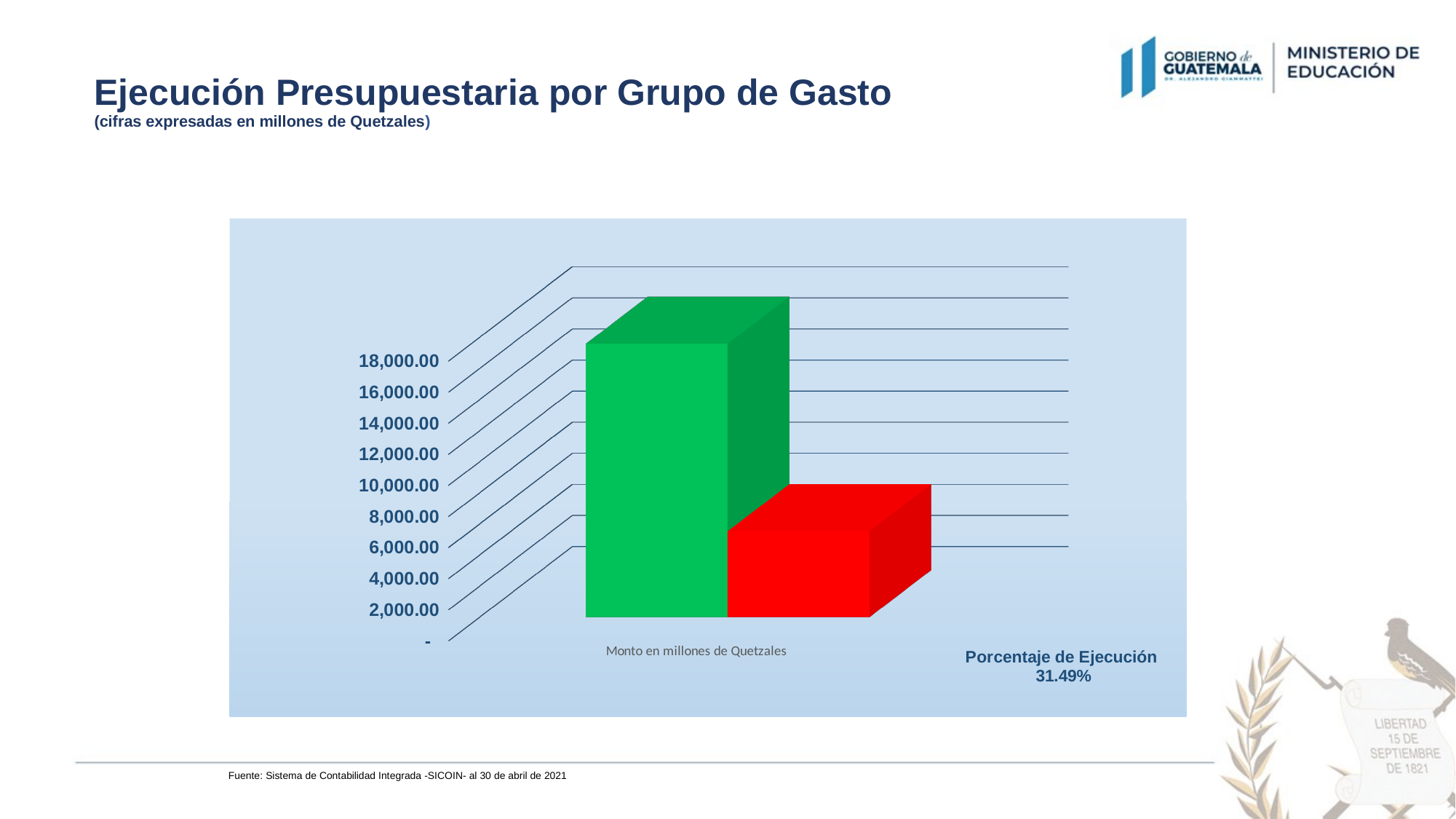
What kind of chart is shown on the slide? bar chart Is the value of the green bar greater or less than 14,000.00? greater Which bar shows the lowest value in the chart? the red bar Is the value of the red bar greater or less than 10,000.00? less What percentage of execution (Porcentaje de Ejecución) is shown on the chart? 31.49% Which bar is taller, the green bar or the red bar? the green bar What is the highest value labelled on the vertical axis of the chart? 18,000.00 What is the title of the slide containing the chart? Ejecución Presupuestaria por Grupo de Gasto How many bars are plotted in the chart? 2 Which bar shows the highest value in the chart? the green bar Is the value of the red bar greater or less than 4,000.00? greater